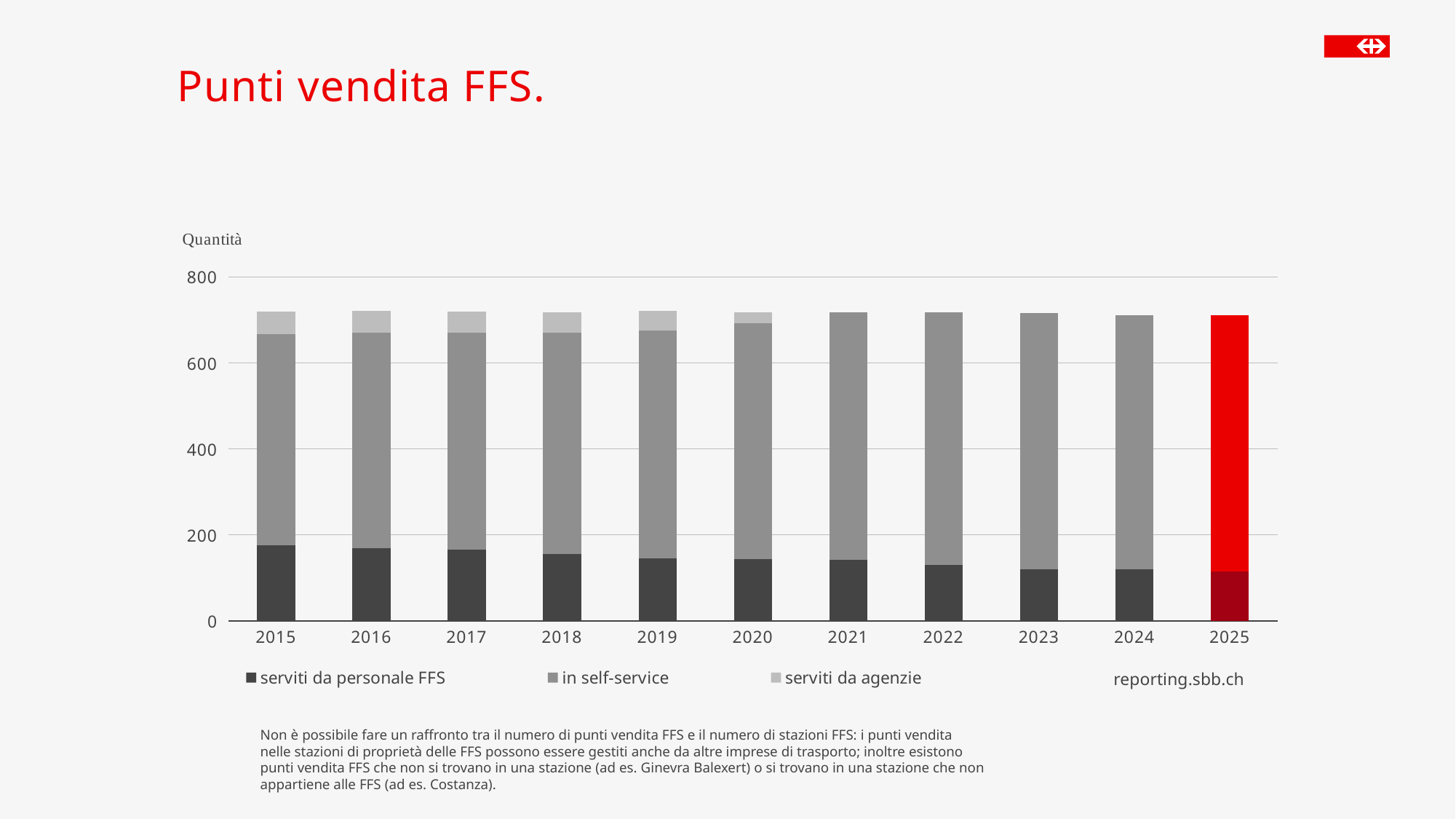
What kind of chart is shown on the slide? stacked bar chart Which year is shown in red in the chart? 2025 How many years are shown on the x axis of the chart? 11 What are the three series listed in the legend? serviti da personale FFS, in self-service, serviti da agenzie Is the value for 'serviti da personale FFS' in 2025 greater or less than 200? less Does the 'serviti da personale FFS' segment rise or fall from 2015 to 2025? fall Is the total number of punti vendita in 2015 greater or less than 600? greater Is the value for 'serviti da personale FFS' in 2015 greater or less than 200? less What is the title of the slide? Punti vendita FFS. How many series does the chart's legend list? 3 Which is larger: the 'serviti da personale FFS' value in 2015 or in 2025? 2015